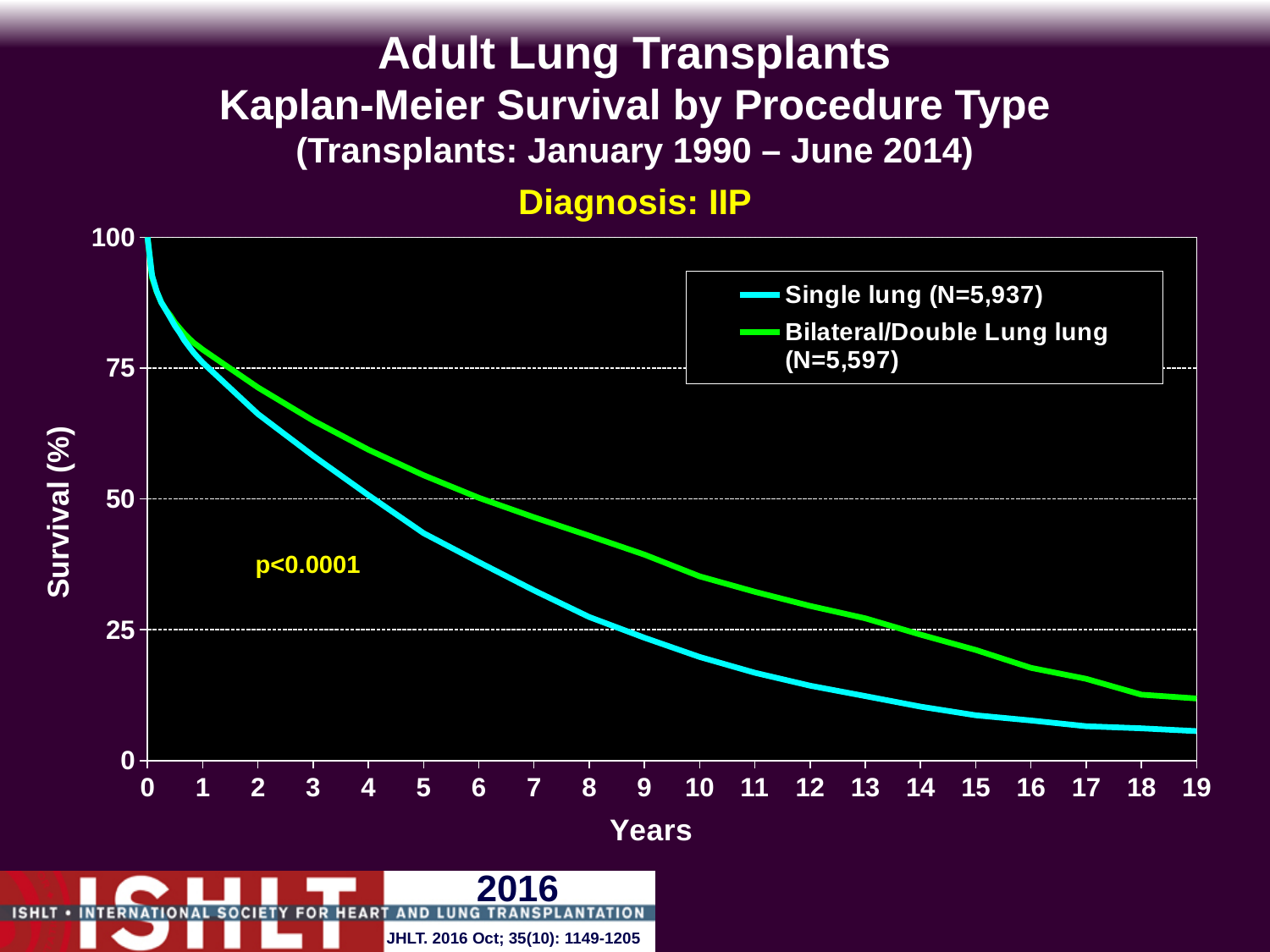
Which procedure type has higher survival at 10 years, Single lung or Bilateral/Double Lung? Bilateral/Double Lung Is the survival value for Single lung at 10 years greater or less than 25? less Is the survival value for Bilateral/Double Lung at 10 years greater or less than 25? greater What kind of chart is shown on the slide? Line chart How many series does the legend list? 2 Which series has the lowest survival at 19 years? Single lung Is the survival value for Bilateral/Double Lung at 15 years greater or less than 25? less Do the survival curves rise or fall as the years increase? Fall What is the N for the Single lung series shown in the legend? 5,937 What p-value is printed on the chart? p<0.0001